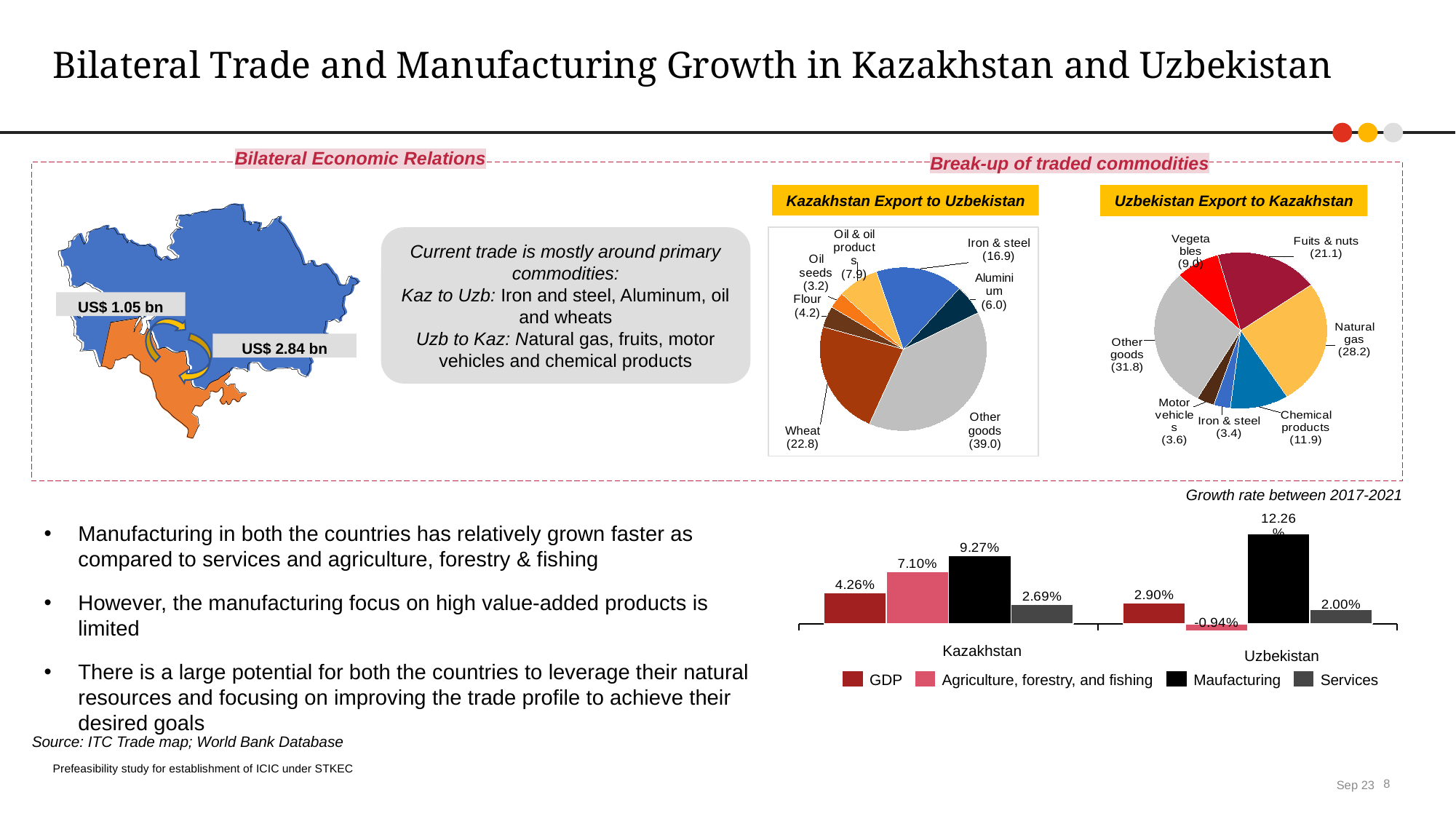
In the 'Kazakhstan Export to Uzbekistan' pie chart, what is the value for Wheat? 22.8 What kind of chart is the 'Kazakhstan Export to Uzbekistan' chart? Pie chart In the bar chart of growth rates between 2017-2021, is the GDP growth rate higher for Kazakhstan or Uzbekistan? Kazakhstan How many series does the legend of the bar chart of growth rates between 2017-2021 list? 4 In the 'Kazakhstan Export to Uzbekistan' pie chart, which category has the largest slice? Other goods How many categories are shown in the 'Uzbekistan Export to Kazakhstan' pie chart? 7 In the bar chart of growth rates between 2017-2021, what is the agriculture, forestry, and fishing growth rate for Uzbekistan? -0.94% In the bar chart of growth rates between 2017-2021, what is the difference between the manufacturing growth rates of Uzbekistan and Kazakhstan? 2.99% In the 'Uzbekistan Export to Kazakhstan' pie chart, what is the value for Natural gas? 28.2 In the bar chart of growth rates between 2017-2021, what is the manufacturing growth rate for Kazakhstan? 9.27% In the bar chart of growth rates between 2017-2021, which series has the highest value for Uzbekistan? Maufacturing In the bar chart of growth rates between 2017-2021, which series has the lowest value for Kazakhstan? Services